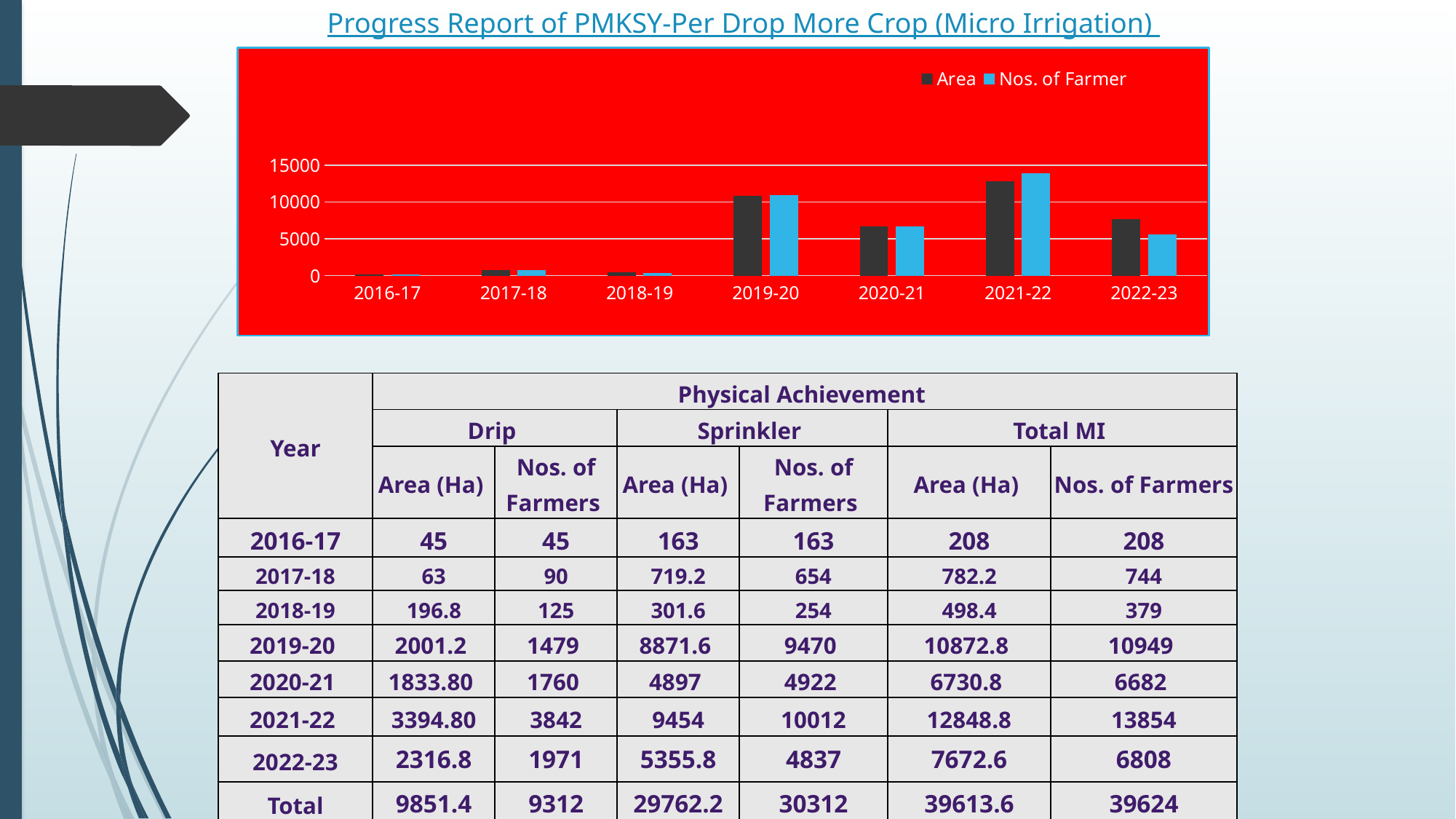
How many years are shown along the x axis of the chart? 7 Is the Area value for 2017-18 greater or less than 5000? less In 2022-23, which is larger in the chart: Area or Nos. of Farmer? Area Which year has the highest Nos. of Farmer bar in the chart? 2021-22 Does the Area value rise or fall from 2019-20 to 2020-21? fall What colour are the Nos. of Farmer bars in the chart? light blue Is the Nos. of Farmer value for 2021-22 greater or less than 15000? less Is the Area value for 2021-22 greater or less than 10000? greater Which year has the highest Area bar in the chart? 2021-22 How many series does the chart legend list? 2 What kind of chart is shown on the slide? bar chart